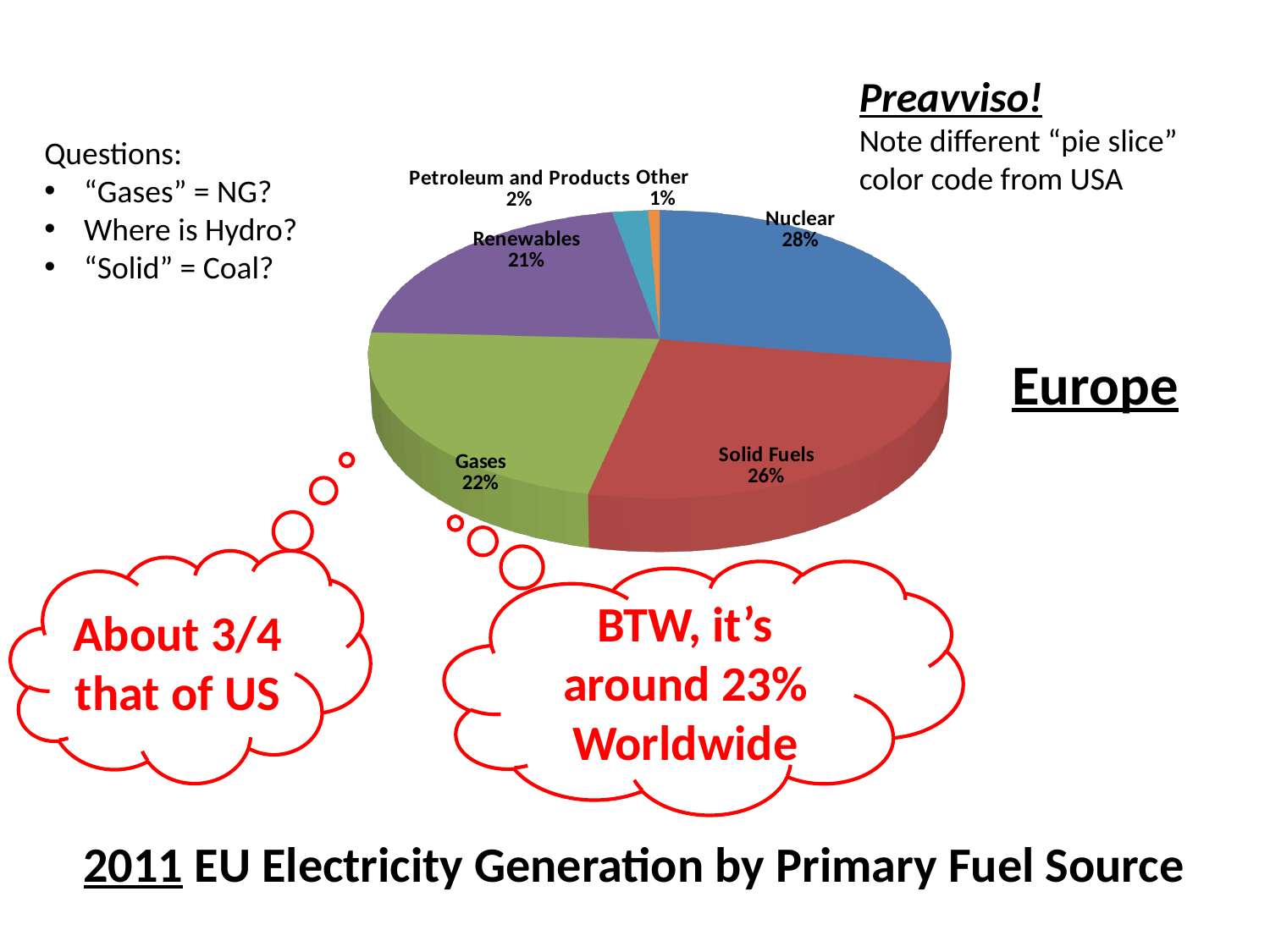
What type of chart is shown on the slide? Pie chart How many percentage points larger is Nuclear than Renewables? 7 What share is labelled for Petroleum and Products? 2% Which fuel source has the largest slice of the pie? Nuclear What colour is the Renewables slice? Purple How many slices does the pie chart have? 6 What percentage of the pie is Solid Fuels? 26% What share does Gases have in the pie chart? 22% Which is larger, the Solid Fuels slice or the Gases slice? Solid Fuels What share of EU electricity generation comes from Nuclear? 28% Which fuel source has the smallest slice of the pie? Other What percentage is shown for Renewables? 21%